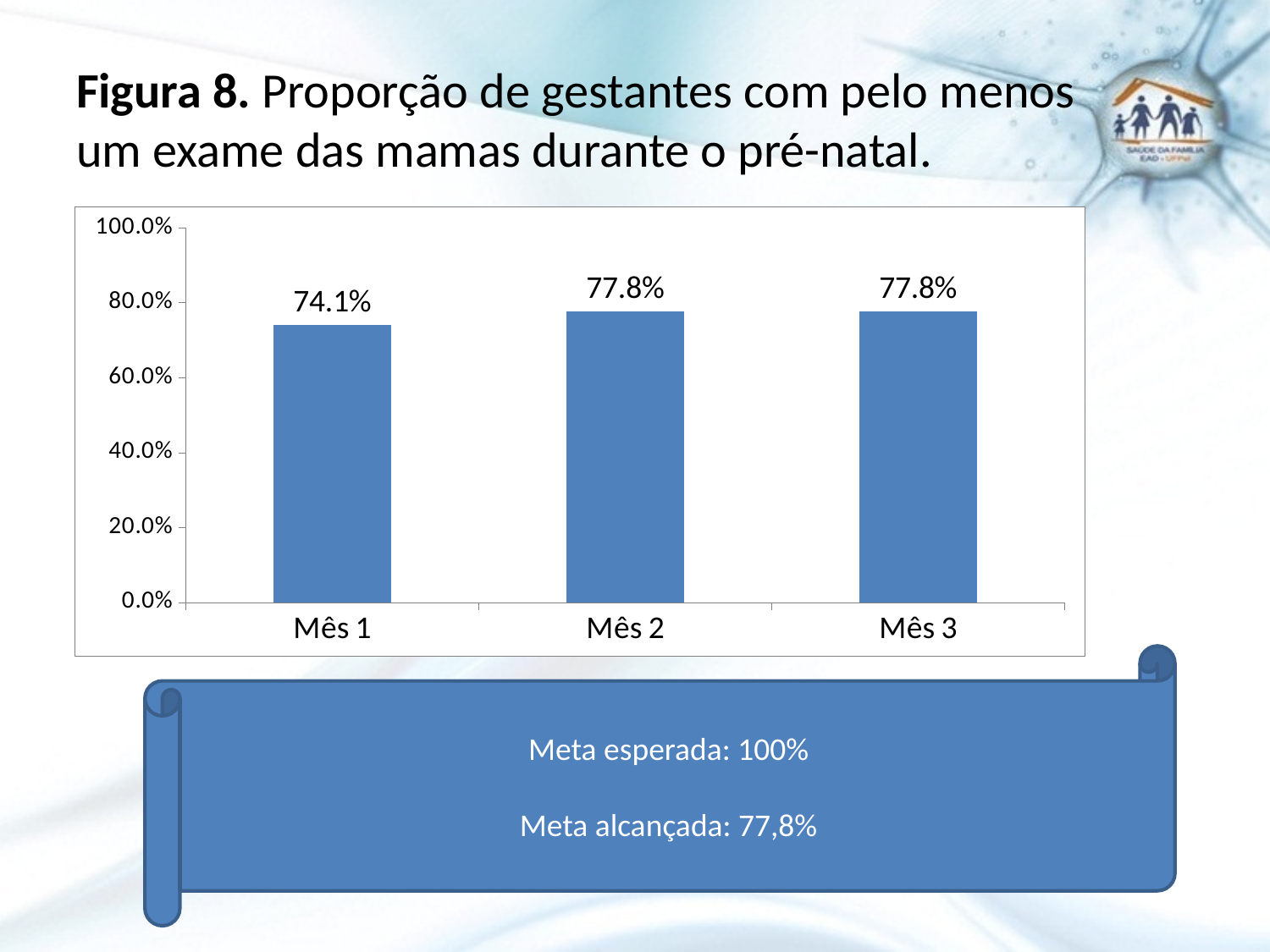
What is the value for Mês 2? 77.8% What kind of chart is shown on the slide? bar chart Is the value for Mês 2 greater or less than 60.0%? greater Which is larger, the value for Mês 1 or the value for Mês 3? Mês 3 What is the difference between the values for Mês 2 and Mês 1? 3.7% Do the values rise or fall from Mês 1 to Mês 2? rise Which month has the lowest value? Mês 1 What is the maximum value shown on the y axis? 100.0% What is the value for Mês 3? 77.8% Is the value for Mês 1 greater or less than 80.0%? less How many categories are shown on the x axis? 3 What is the value for Mês 1? 74.1%